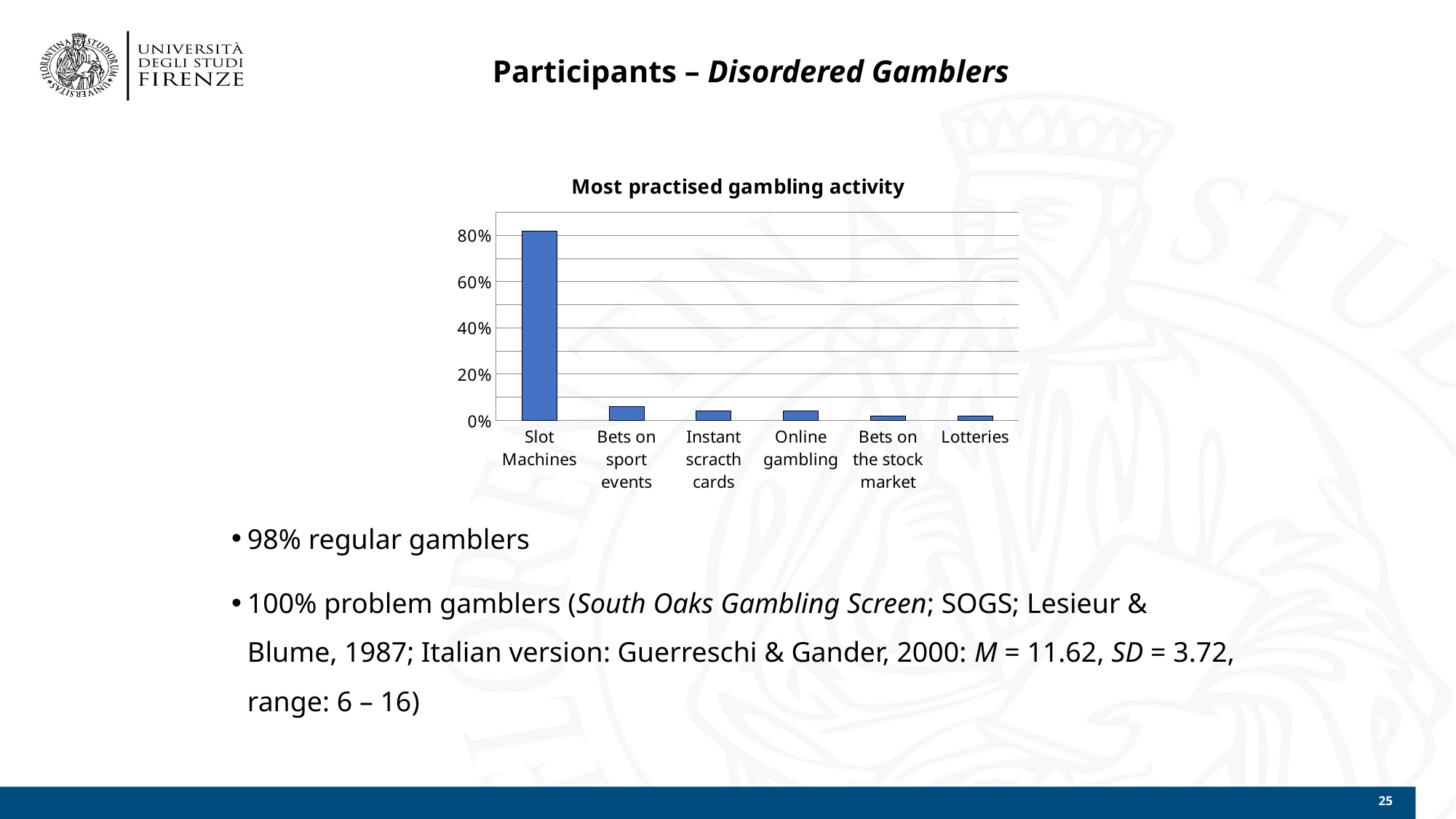
Which is larger, the value for Slot Machines or the value for Bets on sport events? Slot Machines Do the values generally rise or fall moving from left to right along the x axis? fall Is the value for Bets on sport events greater or less than 20%? less How many gambling activities are shown on the x axis of the chart? 6 Is the value for Slot Machines greater or less than 60%? greater Which is larger, the value for Slot Machines or the value for Lotteries? Slot Machines Which gambling activity has the highest value in the chart? Slot Machines Is the value for Lotteries greater or less than 20%? less What kind of chart is shown on the slide? bar chart What is the highest percentage tick label shown on the y axis of the chart? 80% What is the title of the chart? Most practised gambling activity